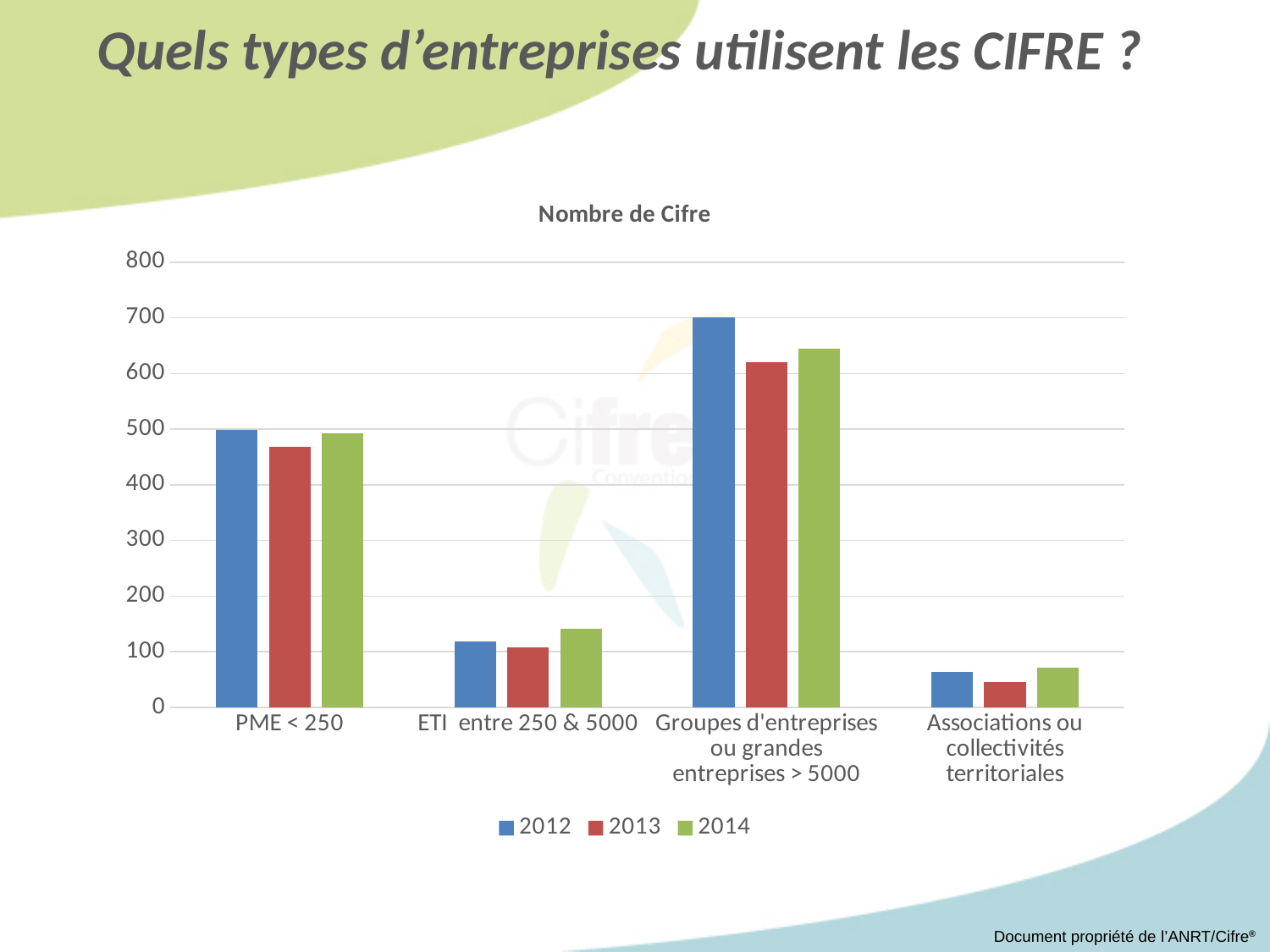
How many categories are shown on the x axis? 4 Is the 2013 value for PME < 250 greater or less than 500? less Is the 2013 value for Associations ou collectivités territoriales greater or less than 100? less How many series does the legend list? 3 Which category has the highest value for 2012? Groupes d'entreprises ou grandes entreprises > 5000 For PME < 250, which year has the larger value, 2012 or 2013? 2012 Which category has the lowest value for 2014? Associations ou collectivités territoriales For Groupes d'entreprises ou grandes entreprises > 5000, did the value rise or fall from 2012 to 2013? fall Is the 2013 value for Groupes d'entreprises ou grandes entreprises > 5000 greater or less than 600? greater What is the title of the chart? Nombre de Cifre What type of chart is shown on the slide? bar chart